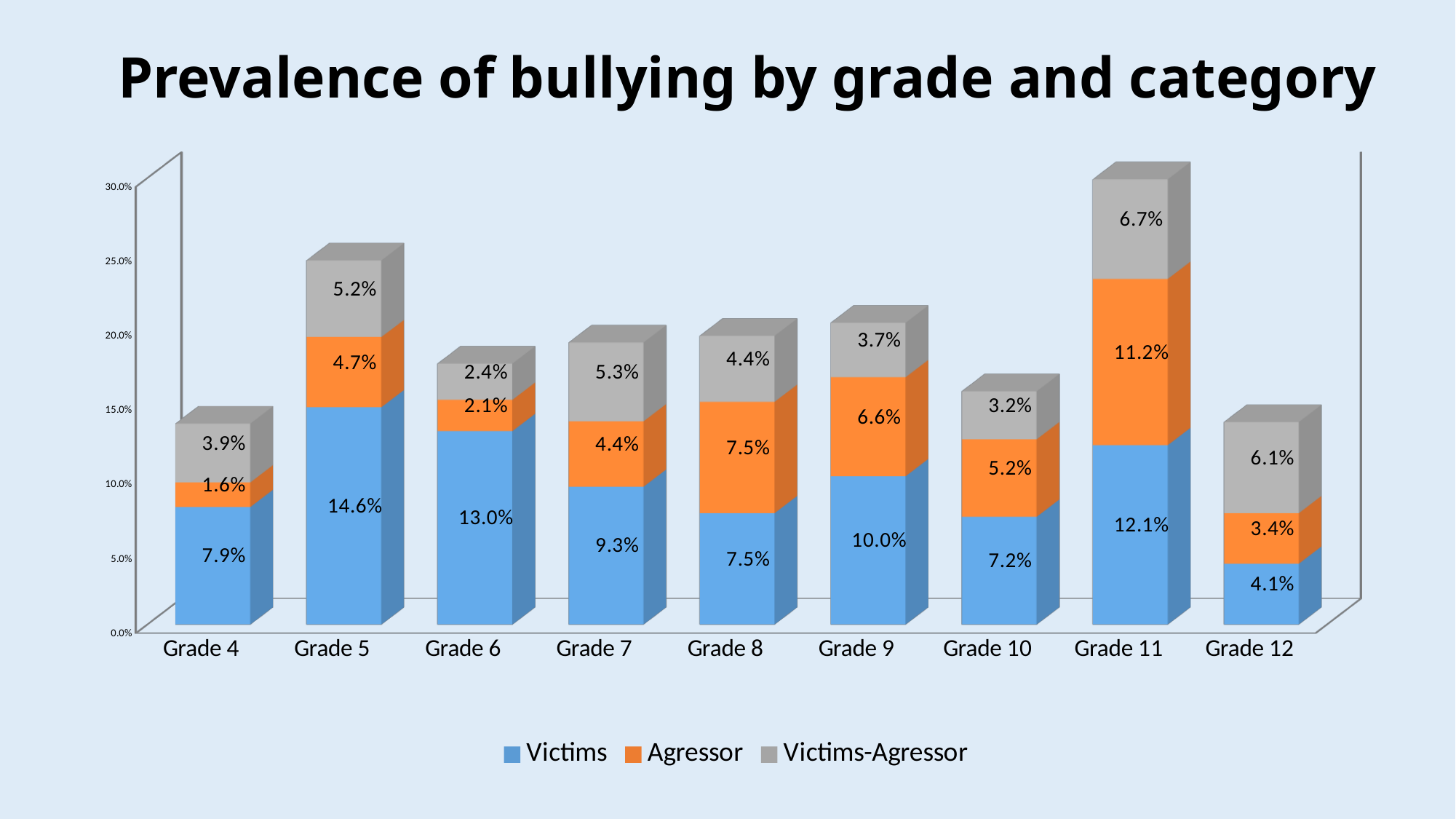
What is the Victims-Agressor value for Grade 12? 6.1% What is the Victims value for Grade 5? 14.6% Which is larger, the Agressor value for Grade 8 or for Grade 9? Grade 8 Which grade has the lowest Agressor value? Grade 4 Which grade has the highest Victims value? Grade 5 What is the difference between the Victims values for Grade 6 and Grade 12? 8.9% What is the total of the stacked bar for Grade 11? 30.0% How many grades are shown on the x axis? 9 How many series does the legend list? 3 What kind of chart is shown on the slide? Stacked bar chart What is the Agressor value for Grade 11? 11.2% What is the total of the stacked bar for Grade 4? 13.4%